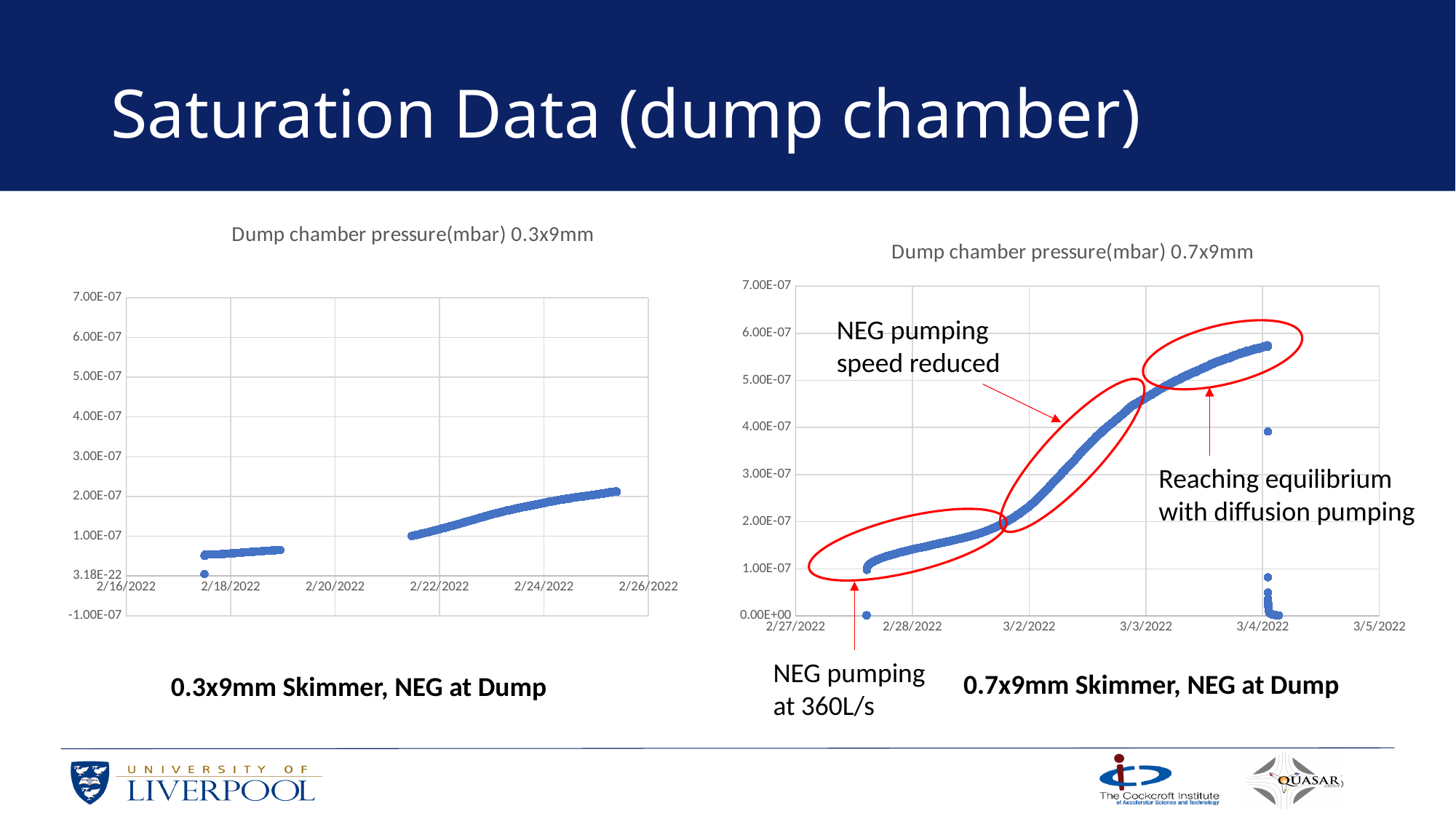
What kind of chart is the 'Dump chamber pressure(mbar) 0.3x9mm' chart? scatter chart In the 'Dump chamber pressure(mbar) 0.7x9mm' chart, is the highest plotted pressure near 3/4/2022 greater or less than 5.00E-07? greater In the 'Dump chamber pressure(mbar) 0.7x9mm' chart, what NEG pumping speed is annotated at the start of the data? 360L/s Which chart reaches a higher maximum plotted pressure, the 0.3x9mm chart or the 0.7x9mm chart? the 0.7x9mm chart What is the title of the chart on the right of the slide? Dump chamber pressure(mbar) 0.7x9mm In the 'Dump chamber pressure(mbar) 0.3x9mm' chart, do the plotted values rise or fall between 2/22/2022 and 2/26/2022? rise In the 'Dump chamber pressure(mbar) 0.7x9mm' chart, do the plotted pressure values rise or fall from 2/27/2022 to 3/4/2022? rise In the 'Dump chamber pressure(mbar) 0.3x9mm' chart, is the highest plotted pressure near 2/26/2022 greater or less than 3.00E-07? less How many charts are shown on the slide? 2 In the 'Dump chamber pressure(mbar) 0.7x9mm' chart, is the pressure value at 3/3/2022 greater or less than 4.00E-07? greater